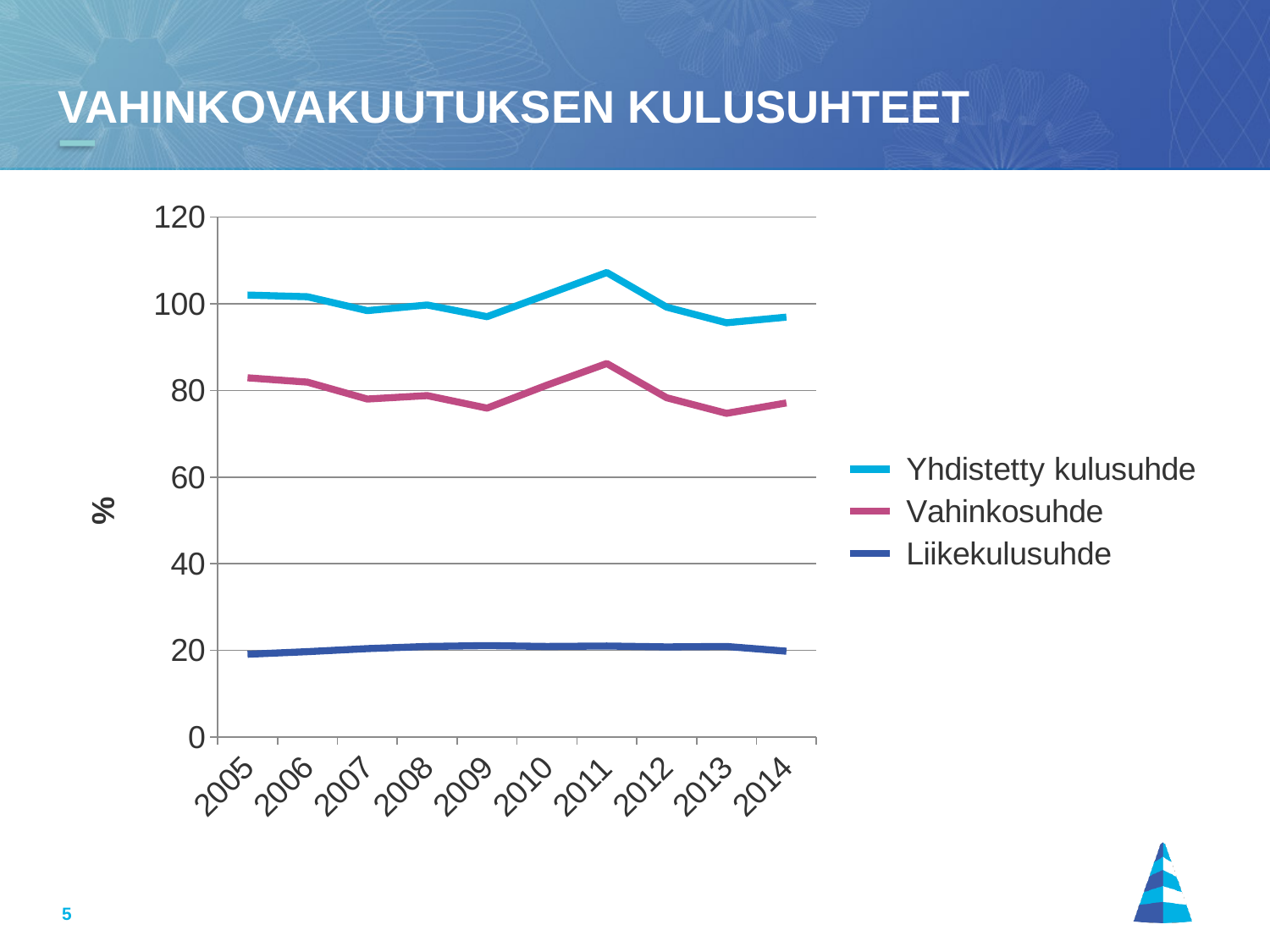
Does Yhdistetty kulusuhde rise or fall from 2011 to 2013? fall In which year is Vahinkosuhde highest? 2011 What is the label on the y axis? % How many series does the legend list? 3 What kind of chart is shown on the slide? line chart Which is larger: Vahinkosuhde in 2005 or Vahinkosuhde in 2009? 2005 Is the value for Vahinkosuhde in 2009 greater or less than 80? less In which year is Yhdistetty kulusuhde highest? 2011 Is the value for Yhdistetty kulusuhde in 2013 greater or less than 100? less How many years are shown on the x axis? 10 Is the value for Yhdistetty kulusuhde in 2011 greater or less than 100? greater